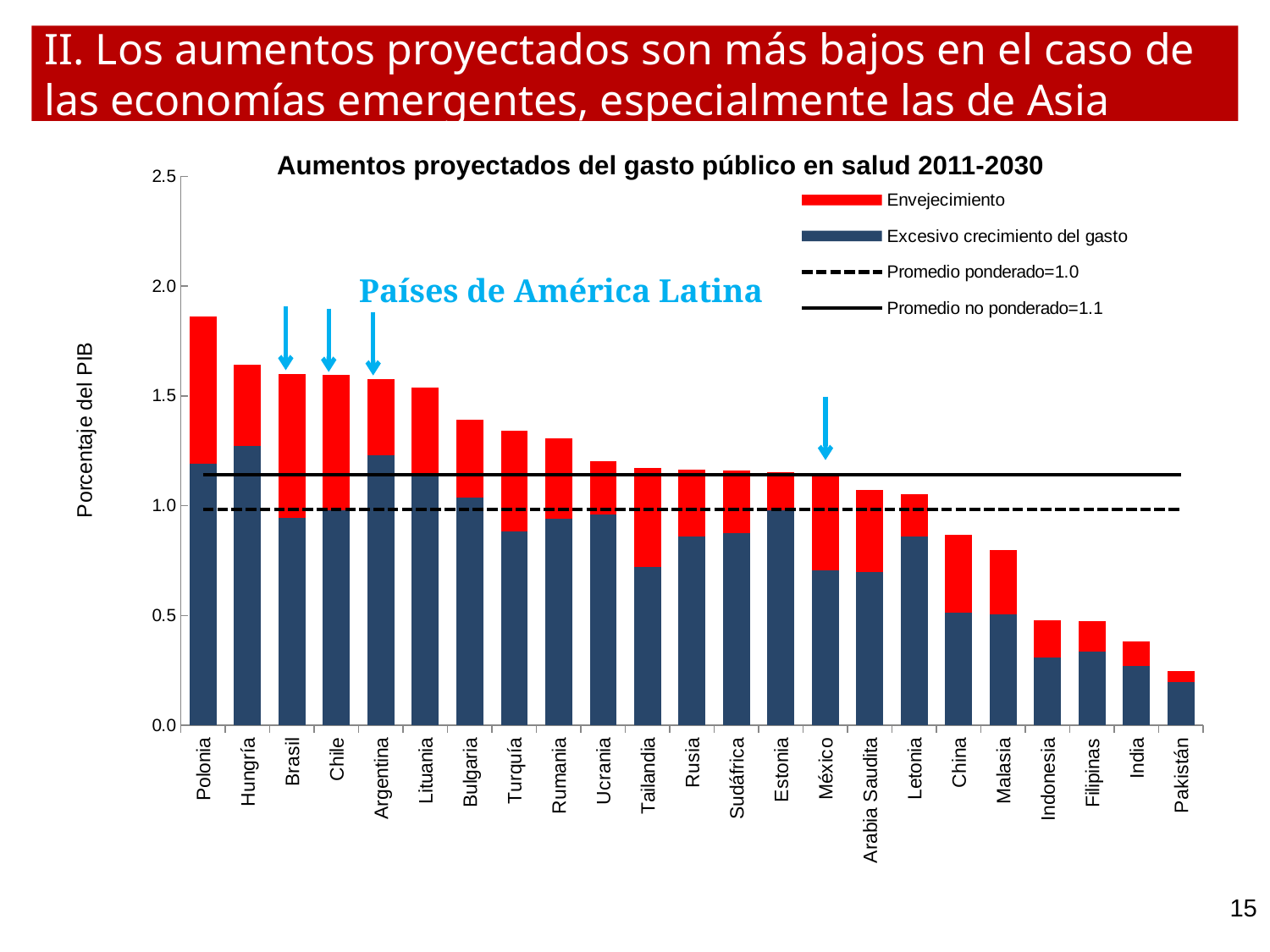
Do the total bar heights rise or fall moving from left to right along the x axis? fall According to the legend, what is the value of the 'Promedio no ponderado' line? 1.1 Is the total value for China greater or less than 1.0? less Is the total value for Polonia greater or less than 1.5? greater Which country has the highest total projected increase in the chart? Polonia How many entries does the chart legend list? 4 What is the title of the chart? Aumentos proyectados del gasto público en salud 2011-2030 How many countries are shown on the x axis of the chart? 23 Which country has the lowest total projected increase in the chart? Pakistán Which has a larger total projected increase, Hungría or China? Hungría Is the total value for Pakistán greater or less than 0.5? less What kind of chart is shown on the slide? stacked bar chart